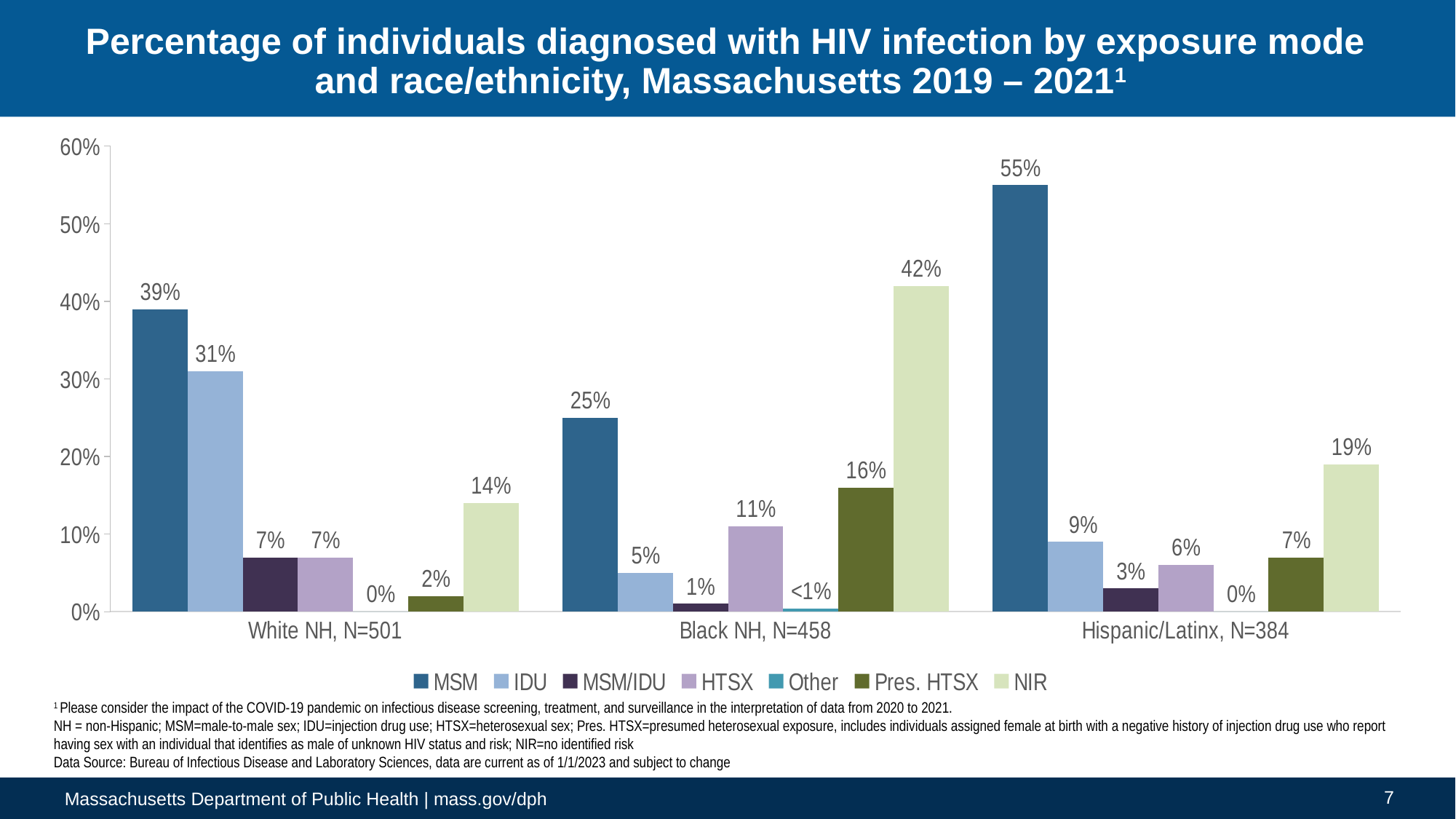
Is the NIR value for the Hispanic/Latinx group greater or less than 10%? greater How many exposure mode series does the legend list? 7 What is the Pres. HTSX percentage for the Black NH group? 16% Which is larger for the Black NH group: the HTSX percentage or the IDU percentage? HTSX What is the IDU percentage for the Hispanic/Latinx group? 9% What kind of chart is shown on the slide? Bar chart What is the NIR percentage for the Black NH group? 42% What is the MSM percentage for the White NH group? 39% How many race/ethnicity groups are shown on the x axis? 3 Which exposure mode has the lowest percentage for the White NH group? Other What is the difference between the MSM percentage for Hispanic/Latinx and the MSM percentage for White NH? 16% Which race/ethnicity group has the highest MSM percentage? Hispanic/Latinx, N=384